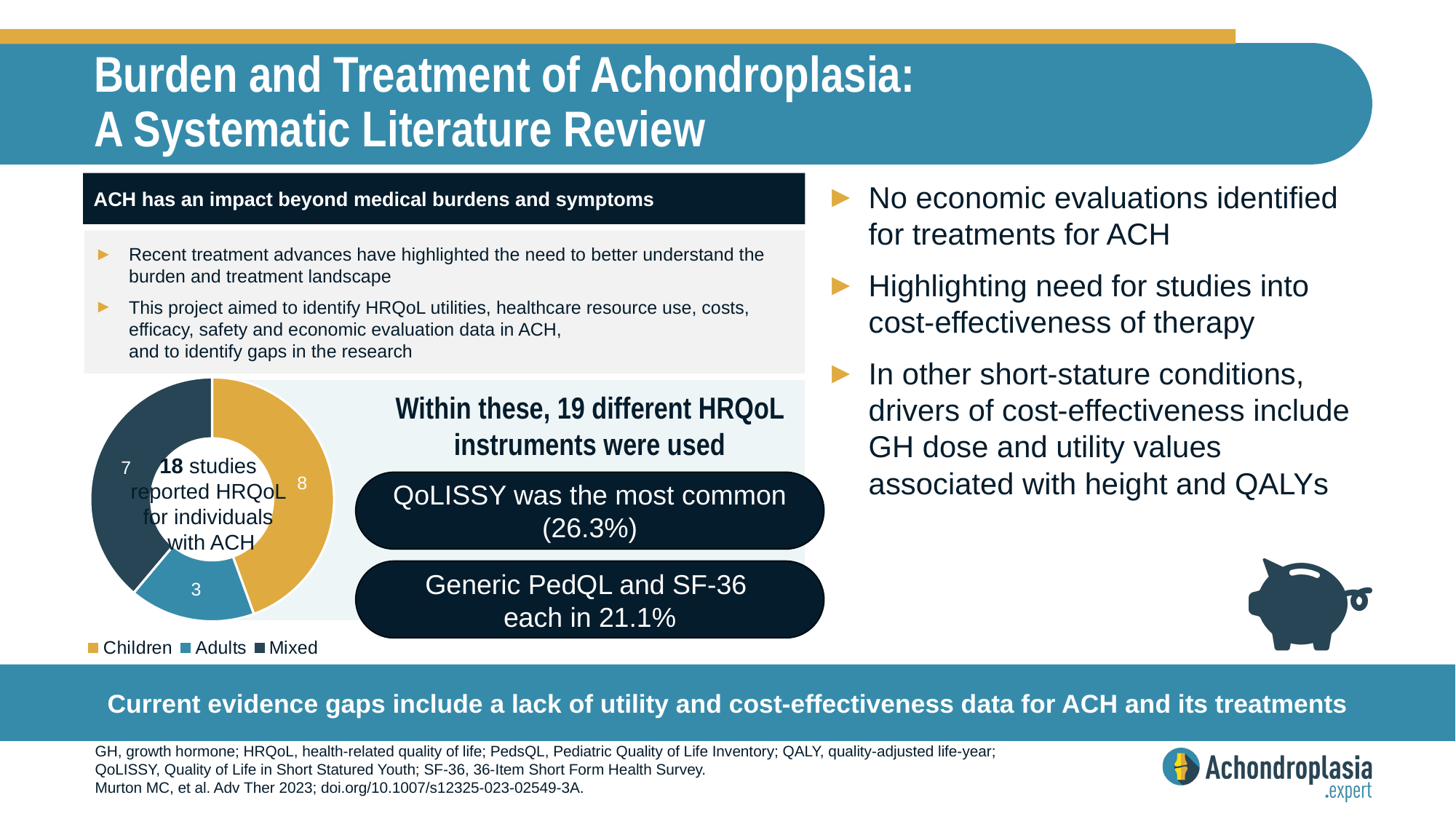
How many studies in the donut chart are in the Children category? 8 What is the difference between the number of Children studies and Adults studies in the donut chart? 5 Which colour represents Children in the donut chart? Gold/yellow Which has more studies in the donut chart, Mixed or Adults? Mixed How many categories does the donut chart show? 3 How many entries does the legend of the donut chart list? 3 What kind of chart is shown on the slide? Donut (pie) chart Which category in the donut chart has the most studies? Children What is the total number of studies across all segments of the donut chart? 18 How many studies in the donut chart are in the Adults category? 3 How many studies in the donut chart are in the Mixed category? 7 Which category in the donut chart has the fewest studies? Adults